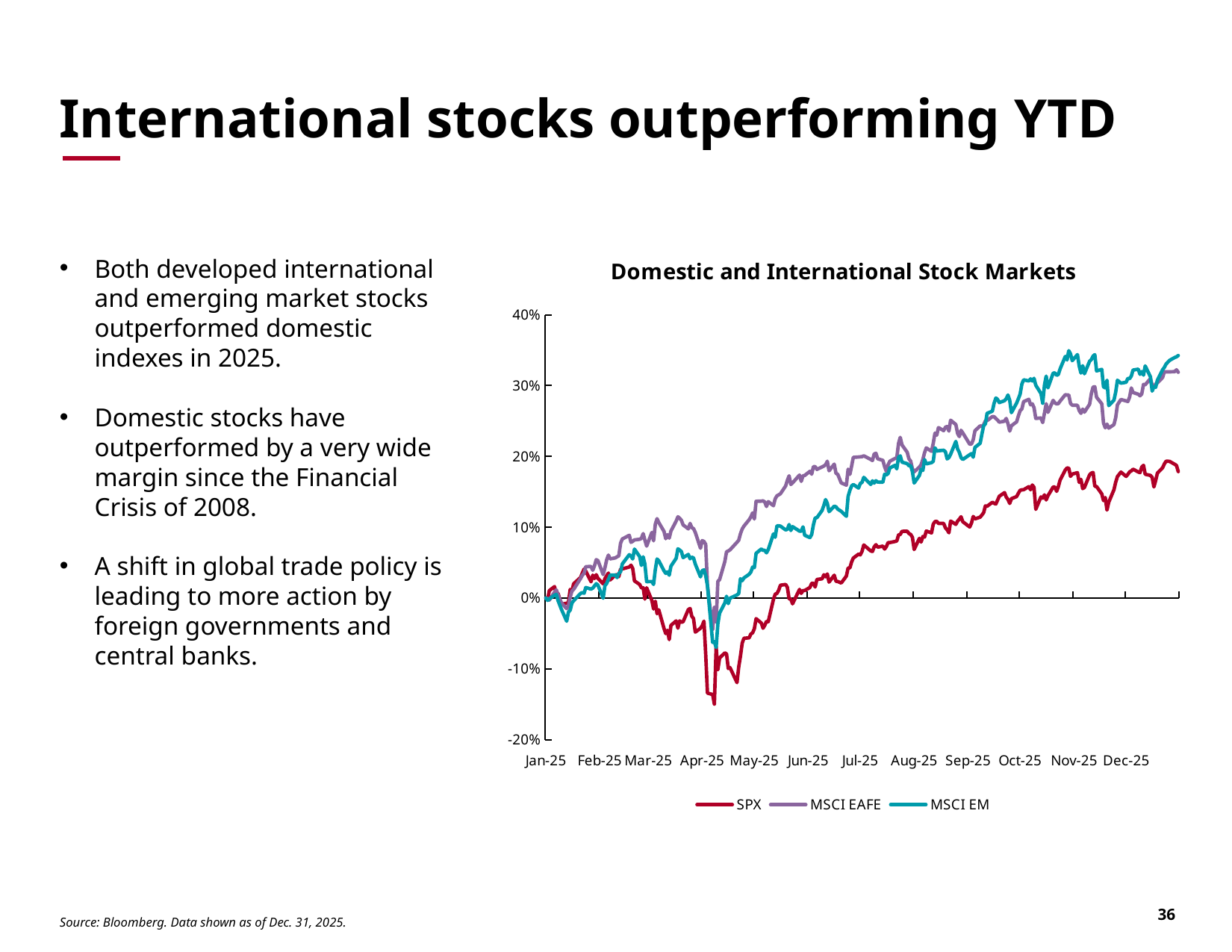
Is the lowest point of the MSCI EM line greater or less than -10%? greater What is the title of the chart? Domestic and International Stock Markets Which series is drawn in red? SPX Is the lowest point of the SPX line greater or less than -10%? less Does the SPX line generally rise or fall from Jun-25 to Dec-25? Rise At the end of Dec-25, which is larger, SPX or MSCI EM? MSCI EM Which series has the lowest value at the end of Dec-25? SPX How many series does the legend list? 3 Is the value for MSCI EM at the end of Dec-25 greater or less than 30%? greater What kind of chart is shown on the slide? Line chart Around Jun-25, which is larger, MSCI EAFE or SPX? MSCI EAFE